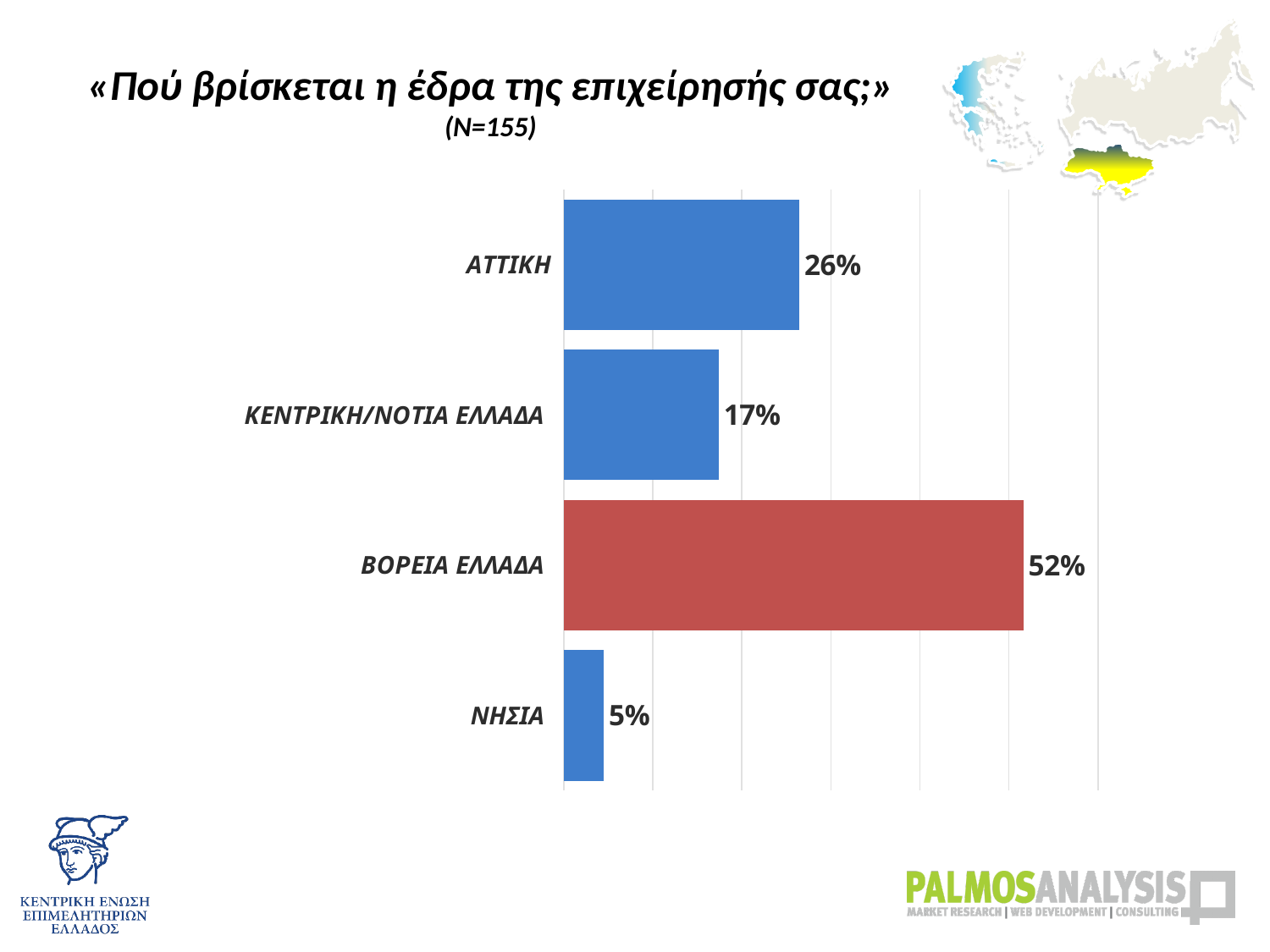
What is the difference between the values for ΑΤΤΙΚΗ and ΚΕΝΤΡΙΚΗ/ΝΟΤΙΑ ΕΛΛΑΔΑ? 9% What is the value for ΚΕΝΤΡΙΚΗ/ΝΟΤΙΑ ΕΛΛΑΔΑ? 17% How many categories are shown in the chart? 4 Which category has the highest value? ΒΟΡΕΙΑ ΕΛΛΑΔΑ What is the value for ΒΟΡΕΙΑ ΕΛΛΑΔΑ? 52% What is the value for ΝΗΣΙΑ? 5% Which is larger, the value for ΚΕΝΤΡΙΚΗ/ΝΟΤΙΑ ΕΛΛΑΔΑ or the value for ΝΗΣΙΑ? ΚΕΝΤΡΙΚΗ/ΝΟΤΙΑ ΕΛΛΑΔΑ Which bar is coloured red rather than blue? ΒΟΡΕΙΑ ΕΛΛΑΔΑ What is the value for ΑΤΤΙΚΗ? 26% Which category has the lowest value? ΝΗΣΙΑ What is the difference between the values for ΒΟΡΕΙΑ ΕΛΛΑΔΑ and ΑΤΤΙΚΗ? 26% What kind of chart is shown on the slide? Bar chart